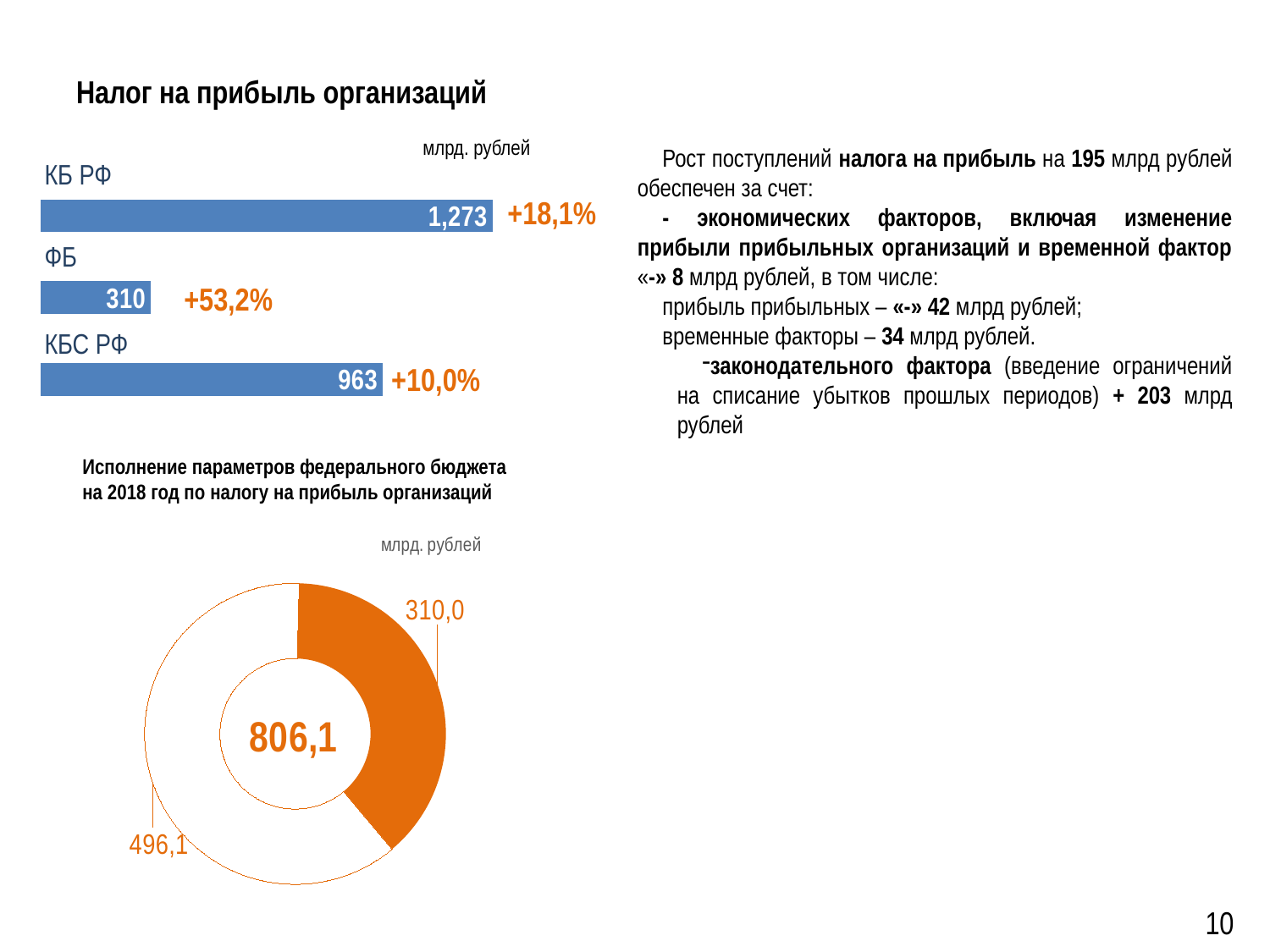
In the top bar chart, what growth percentage is shown next to the ФБ bar? +53,2% In the bottom doughnut chart, what number is printed in the centre? 806,1 What kind of chart is the top chart on the slide? bar chart In the top bar chart, how many categories are shown? 3 In the top bar chart, which category has the highest value? КБ РФ In the bottom doughnut chart, what value is shown for the white segment? 496,1 In the top bar chart, what is the value for КБ РФ? 1,273 In the top bar chart, what is the value for ФБ? 310 In the bottom doughnut chart, what value is shown for the orange segment? 310,0 In the top bar chart, what growth percentage is shown next to the КБС РФ bar? +10,0% In the top bar chart, what is the value for КБС РФ? 963 In the top bar chart, which category has the lowest value? ФБ